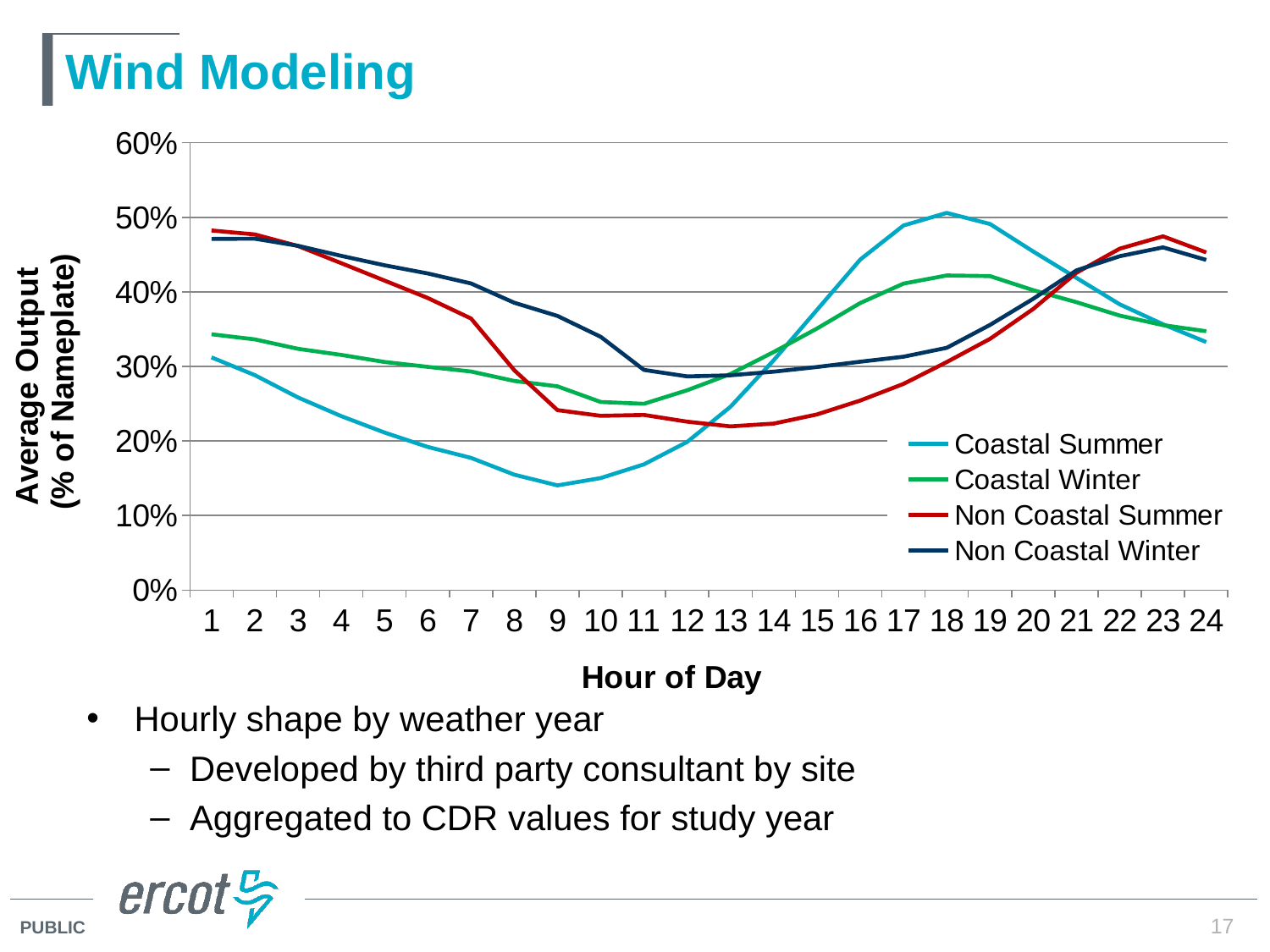
Does the Coastal Summer series rise or fall from hour 1 to hour 9? Fall At hour 13, which is larger: Non Coastal Winter or Non Coastal Summer? Non Coastal Winter How many hours are plotted along the x axis? 24 How many series does the legend list? 4 Is the Coastal Summer value at hour 18 greater or less than 40%? greater What kind of chart is shown on the slide? Line chart At hour 1, which is larger: Non Coastal Summer or Coastal Summer? Non Coastal Summer At which hour of the day does the Coastal Summer series reach its highest value? 18 Is the Coastal Winter value at hour 11 greater or less than 30%? less Is the Non Coastal Summer value at hour 1 greater or less than 40%? greater At which hour of the day does the Coastal Summer series reach its lowest value? 9